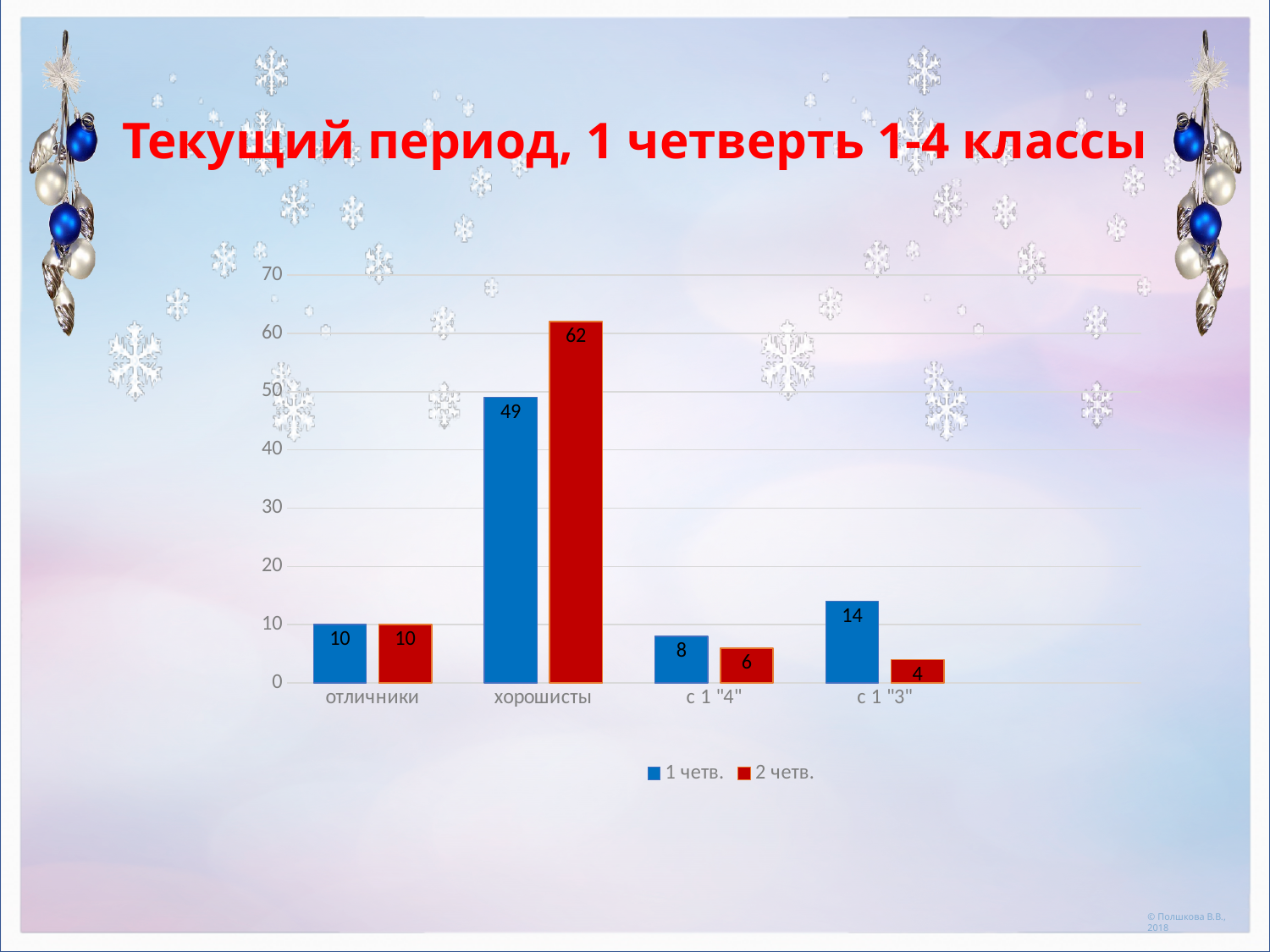
What is the value for хорошисты in the 2 четв. series? 62 Which category has the lowest value in the 2 четв. series? с 1 "3" What is the title of the slide? Текущий период, 1 четверть 1-4 классы Which is larger for с 1 "3": the 1 четв. value or the 2 четв. value? 1 четв. Which category has the highest value in the 2 четв. series? хорошисты What is the value for с 1 "4" in the 2 четв. series? 6 How many categories are shown on the x axis? 4 What is the value for с 1 "3" in the 1 четв. series? 14 What is the difference between the 2 четв. and 1 четв. values for хорошисты? 13 How many series does the legend list? 2 What kind of chart is shown on the slide? bar chart What is the value for хорошисты in the 1 четв. series? 49